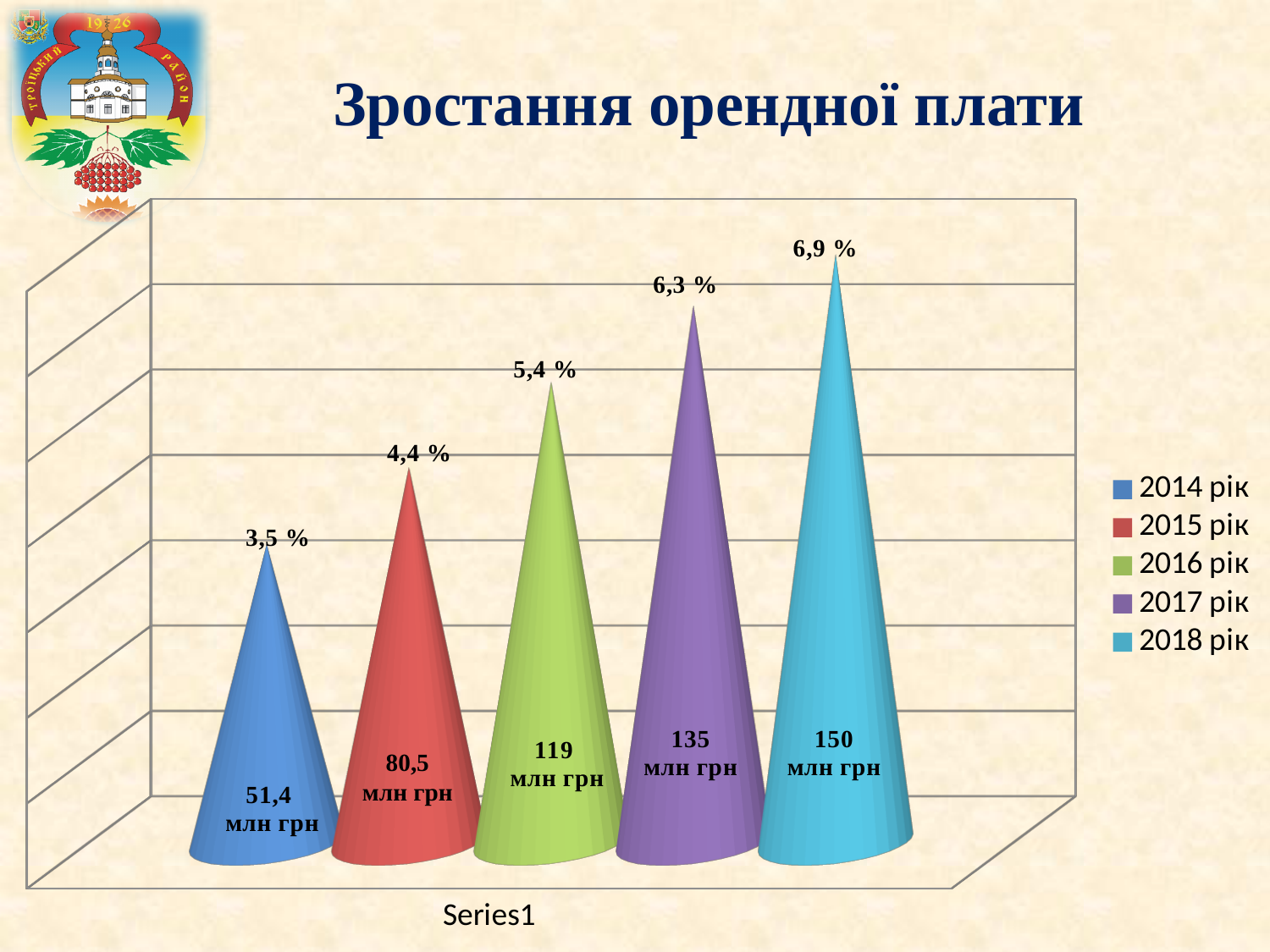
What is the percentage label shown above the bar for 2018 рік? 6,9 % Which year has the highest bar in the chart? 2018 рік What is the difference between the percentage labels for 2018 рік and 2014 рік? 3,4 % What is the percentage label shown above the bar for 2014 рік? 3,5 % What amount in млн грн is printed on the bar for 2015 рік? 80,5 млн грн How many entries does the legend list? 5 What amount in млн грн is printed on the bar for 2016 рік? 119 млн грн Which year has the lowest bar in the chart? 2014 рік Do the values rise or fall from 2014 рік to 2018 рік? Rise Which is larger, the bar for 2017 рік or the bar for 2015 рік? 2017 рік What kind of chart is shown on the slide? Bar chart How many bars are plotted in the chart? 5